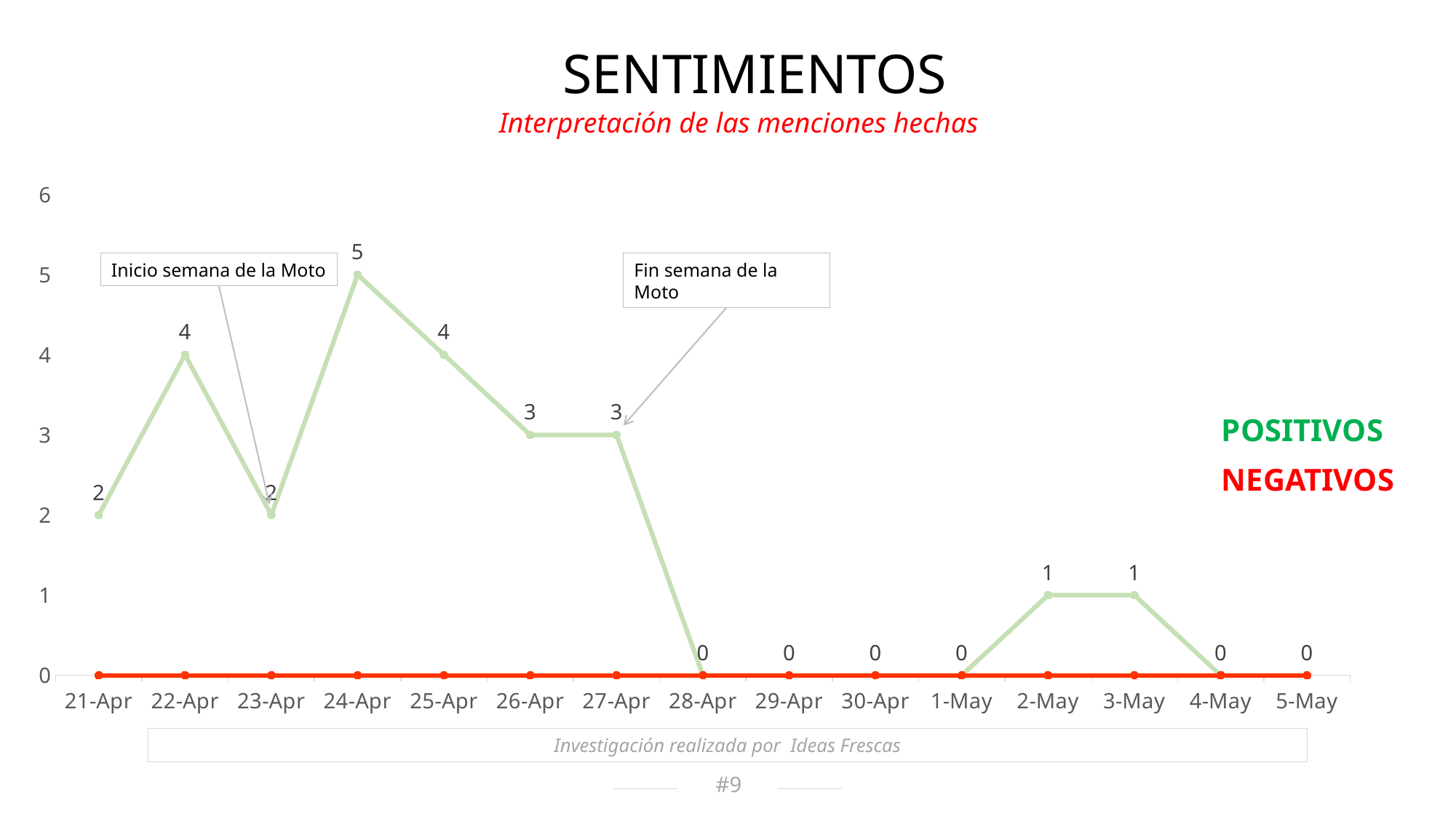
How many series does the legend list? 2 Does the POSITIVOS line rise or fall from 24-Apr to 28-Apr? fall What is the POSITIVOS value on 24-Apr? 5 Which is larger, the POSITIVOS value on 25-Apr or on 26-Apr? 25-Apr What kind of chart is shown on the slide? line chart What is the POSITIVOS value on 22-Apr? 4 What is the POSITIVOS value on 2-May? 1 On which date does the POSITIVOS line reach its highest value? 24-Apr What is the POSITIVOS value on 27-Apr? 3 What is the difference between the POSITIVOS values on 24-Apr and 23-Apr? 3 How many dates are shown on the x axis? 15 What is the title of the slide? SENTIMIENTOS